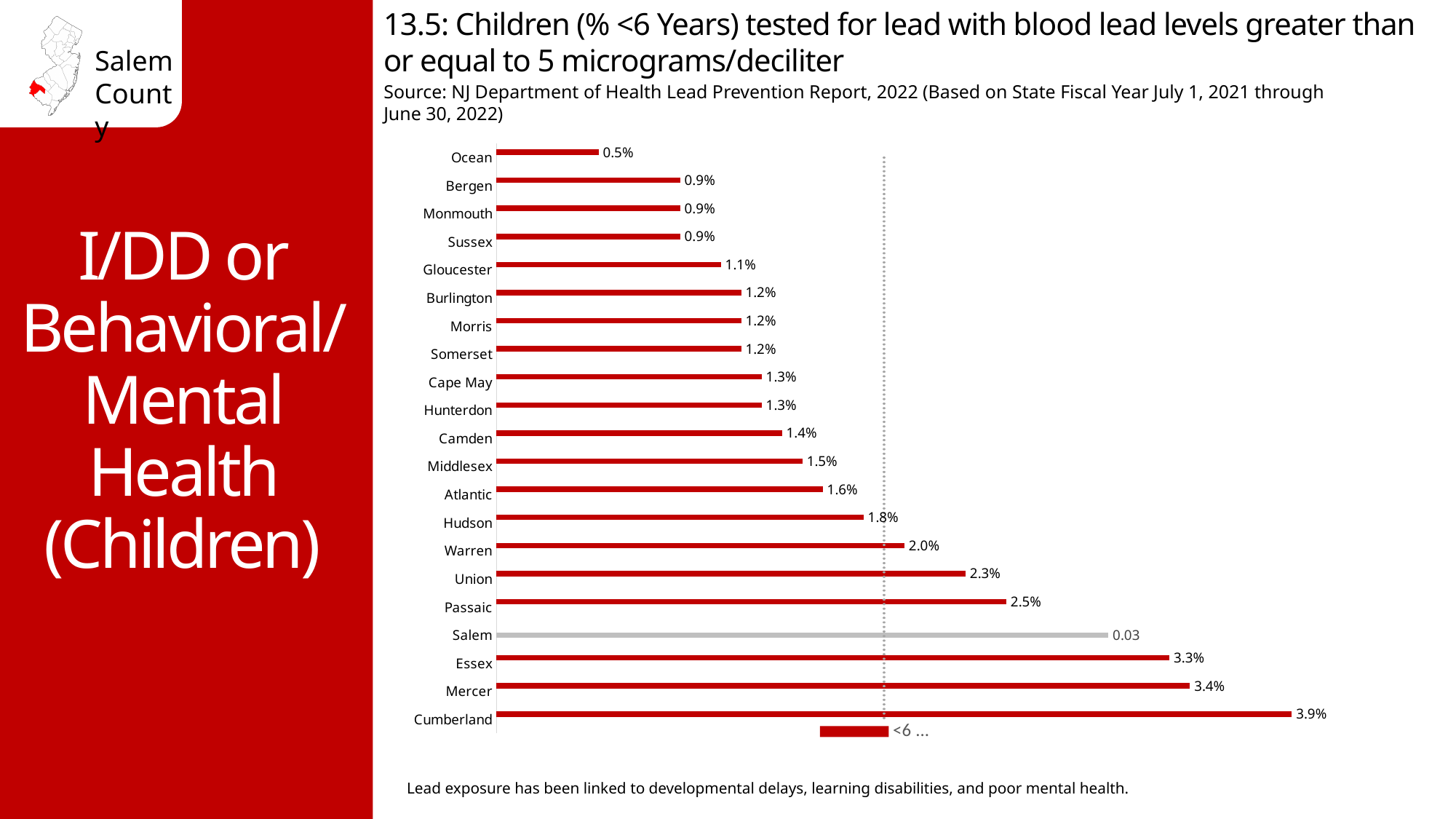
What is the value for Cumberland? 3.9% What value is labeled on the Salem bar? 0.03 What is the value for Passaic? 2.5% What is the difference between the values for Cumberland and Ocean? 3.4% How many counties are shown in the chart? 21 What colour is the Salem bar, unlike the other bars? gray What is the value for Hudson? 1.8% Which has a larger value, Essex or Mercer? Mercer Which county has the highest value? Cumberland Which county has the lowest value? Ocean What kind of chart is shown? bar chart What is the difference between the values for Union and Warren? 0.3%